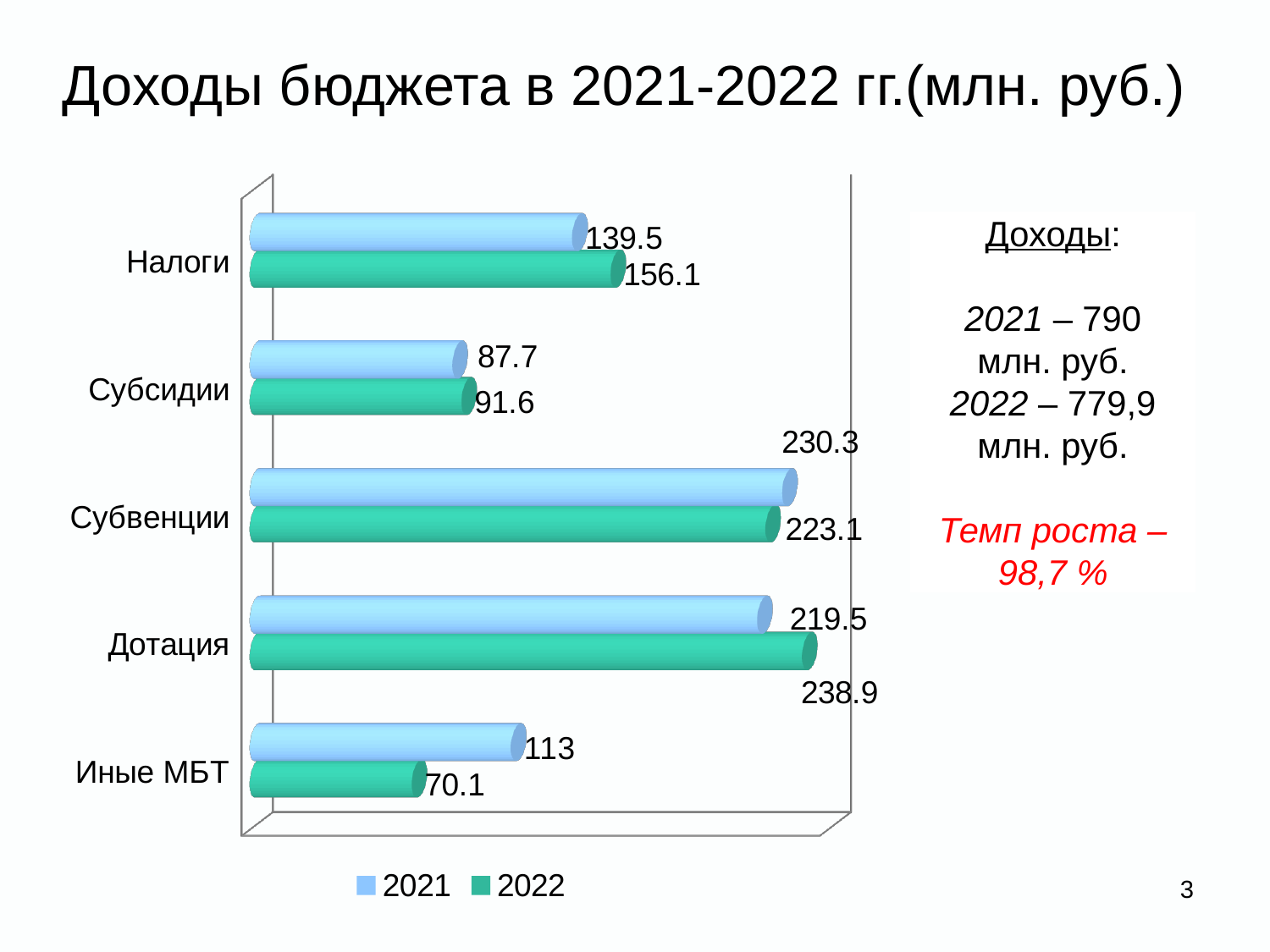
What is the value for Налоги in the 2021 series? 139.5 What is the value for Дотация in the 2022 series? 238.9 How many categories are shown on the chart? 5 Which is larger for Субвенции: the 2021 value or the 2022 value? 2021 What is the difference between the 2022 and 2021 values for Иные МБТ? 42.9 Which category has the highest value in the 2022 series? Дотация What is the difference between the 2022 and 2021 values for Налоги? 16.6 How many series does the legend list? 2 Which category has the lowest value in the 2021 series? Субсидии What is the value for Иные МБТ in the 2021 series? 113 What kind of chart is shown on the slide? Bar chart What is the value for Субсидии in the 2022 series? 91.6